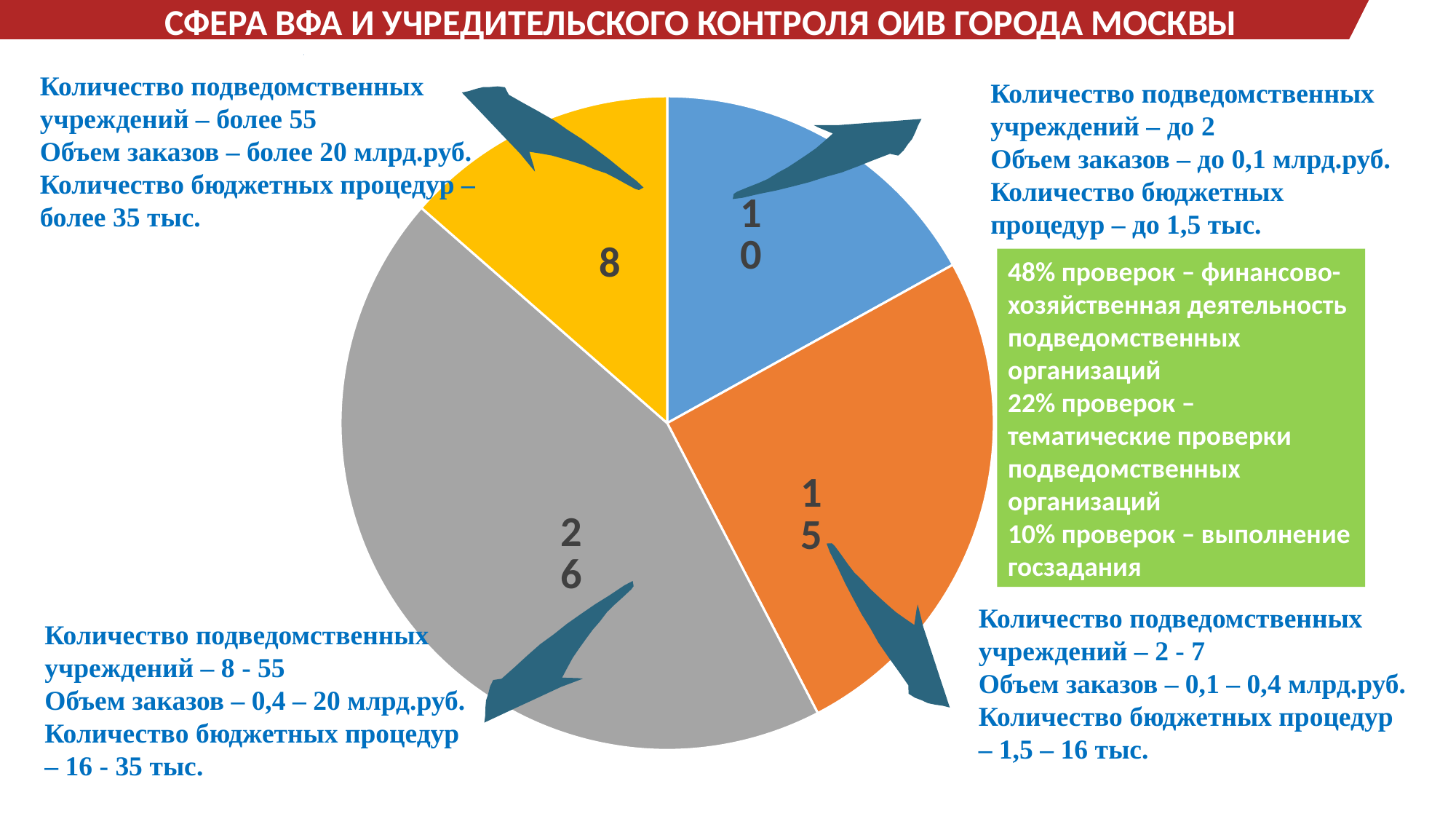
What is the title shown at the top of the slide? СФЕРА ВФА И УЧРЕДИТЕЛЬСКОГО КОНТРОЛЯ ОИВ ГОРОДА МОСКВЫ What is the difference between the grey slice value and the orange slice value? 11 What kind of chart is shown on the slide? pie chart Which slice of the pie chart has the smallest value? the yellow slice (8) Which is larger, the blue slice value or the orange slice value? the orange slice (15) How many slices does the pie chart have? 4 What value is labelled on the blue slice of the pie chart? 10 What value is labelled on the grey slice of the pie chart? 26 What value is labelled on the orange slice of the pie chart? 15 Which slice of the pie chart has the largest value? the grey slice (26) What value is labelled on the yellow slice of the pie chart? 8 What is the sum of all the slice values in the pie chart? 59